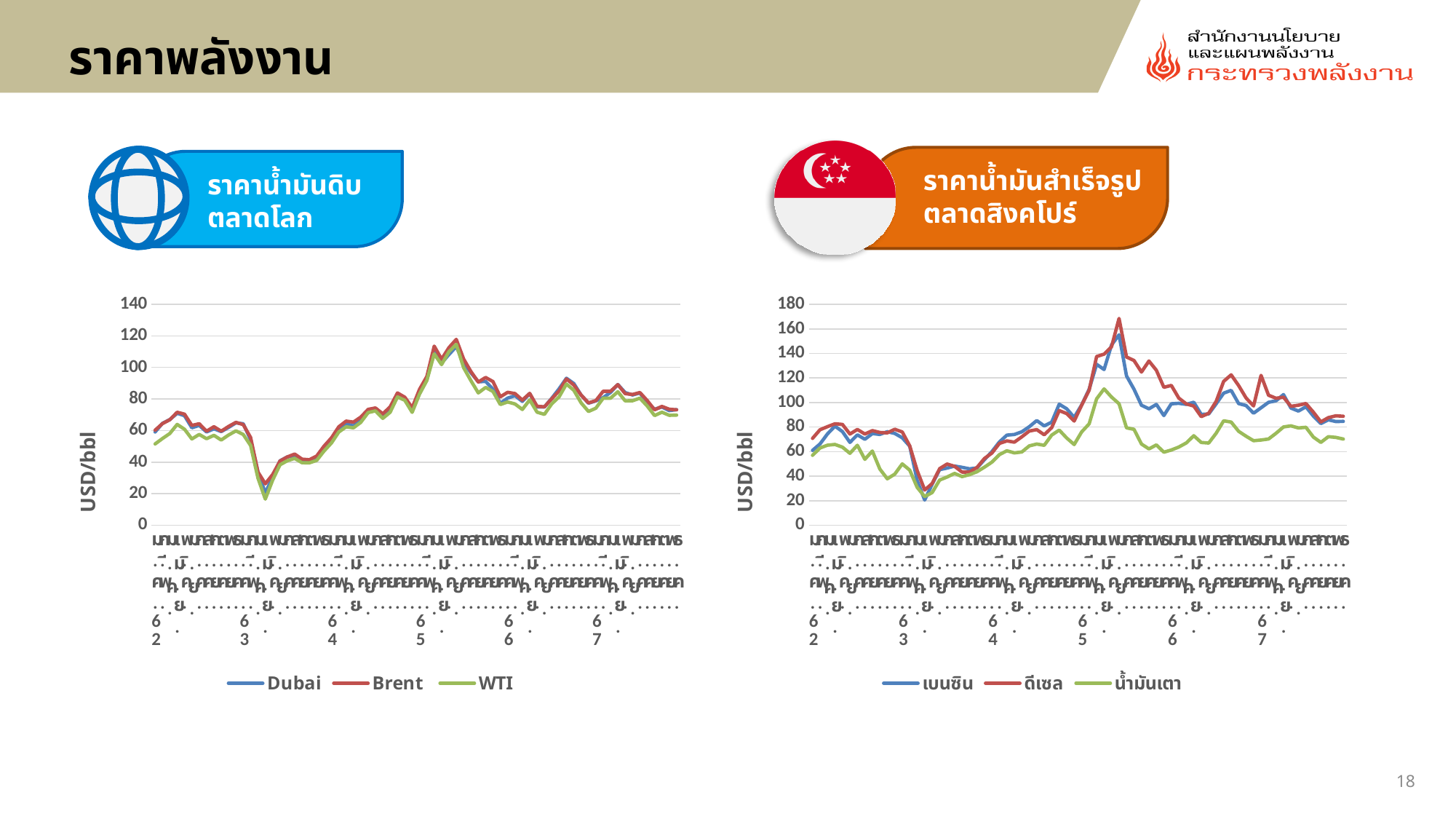
How many series does the legend of the left chart (ราคาน้ำมันดิบตลาดโลก) list? 3 Which series are listed in the legend of the left chart (ราคาน้ำมันดิบตลาดโลก)? Dubai, Brent, WTI In the right chart (ราคาน้ำมันสำเร็จรูปตลาดสิงคโปร์), which series is the lowest at the right end of the x axis? น้ำมันเตา In the left chart (ราคาน้ำมันดิบตลาดโลก), is the highest value reached by Brent greater or less than 100? greater What kind of chart is the left chart (ราคาน้ำมันดิบตลาดโลก)? line chart How many series does the legend of the right chart (ราคาน้ำมันสำเร็จรูปตลาดสิงคโปร์) list? 3 What kind of chart is the right chart (ราคาน้ำมันสำเร็จรูปตลาดสิงคโปร์)? line chart In the right chart (ราคาน้ำมันสำเร็จรูปตลาดสิงคโปร์), is the highest value reached by น้ำมันเตา greater or less than 120? less In the left chart (ราคาน้ำมันดิบตลาดโลก), is the lowest value reached by WTI greater or less than 40? less In the right chart (ราคาน้ำมันสำเร็จรูปตลาดสิงคโปร์), which series reaches the highest peak? ดีเซล What is the y-axis label of the right chart (ราคาน้ำมันสำเร็จรูปตลาดสิงคโปร์)? USD/bbl